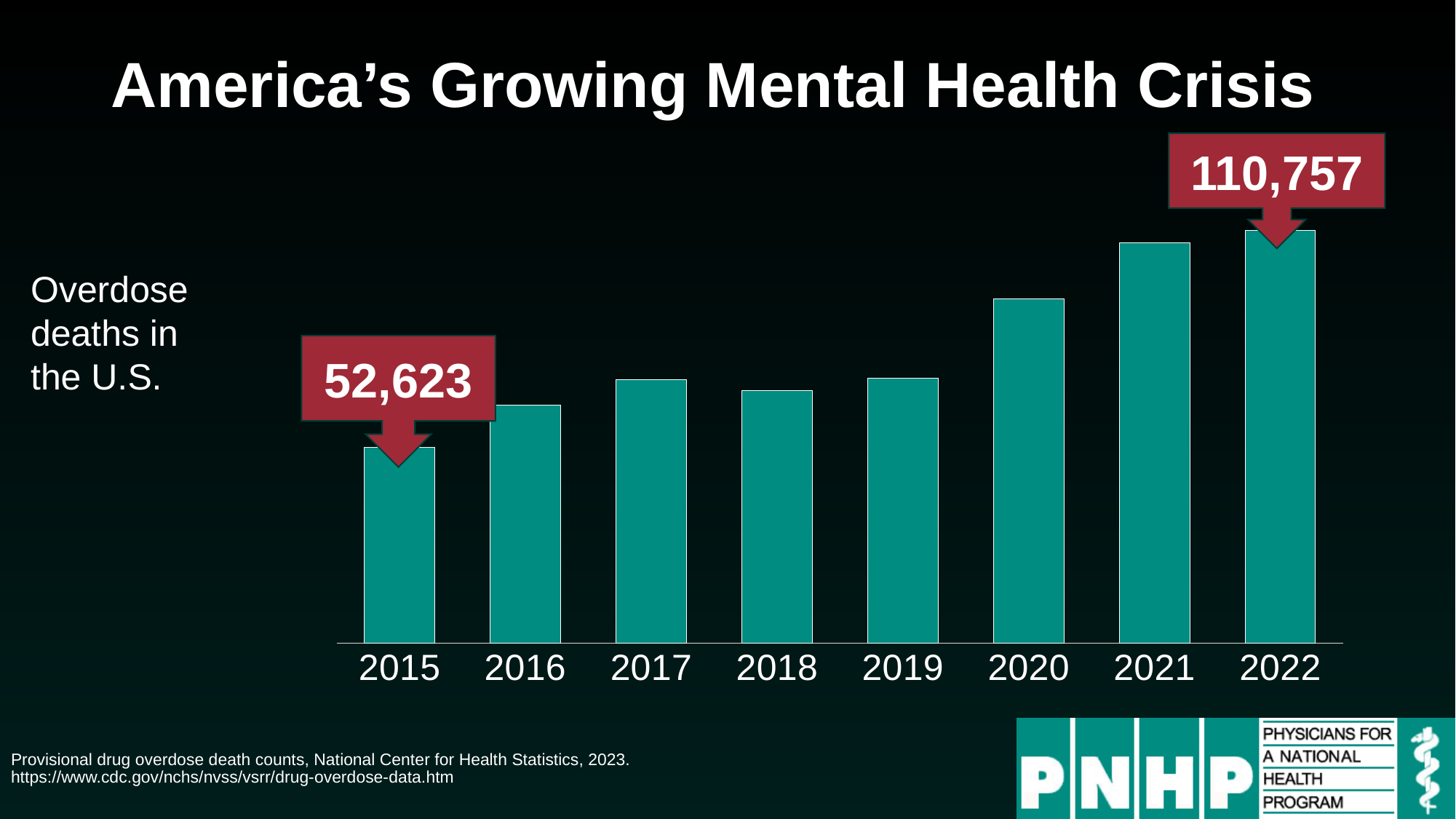
Which year has the highest number of overdose deaths? 2022 What is the value shown for 2022? 110,757 Do the values generally rise or fall from 2015 to 2022? Rise Which year has the larger value, 2020 or 2021? 2021 How many years are shown on the x axis? 8 Which year has the lowest number of overdose deaths? 2015 What is the difference between the 2022 value and the 2015 value? 58,134 Which year has the larger value, 2019 or 2021? 2021 Which year has the larger value, 2016 or 2020? 2020 What is the value shown for 2015? 52,623 What kind of chart is shown on the slide? Bar chart What is the title of the slide containing the chart? America's Growing Mental Health Crisis